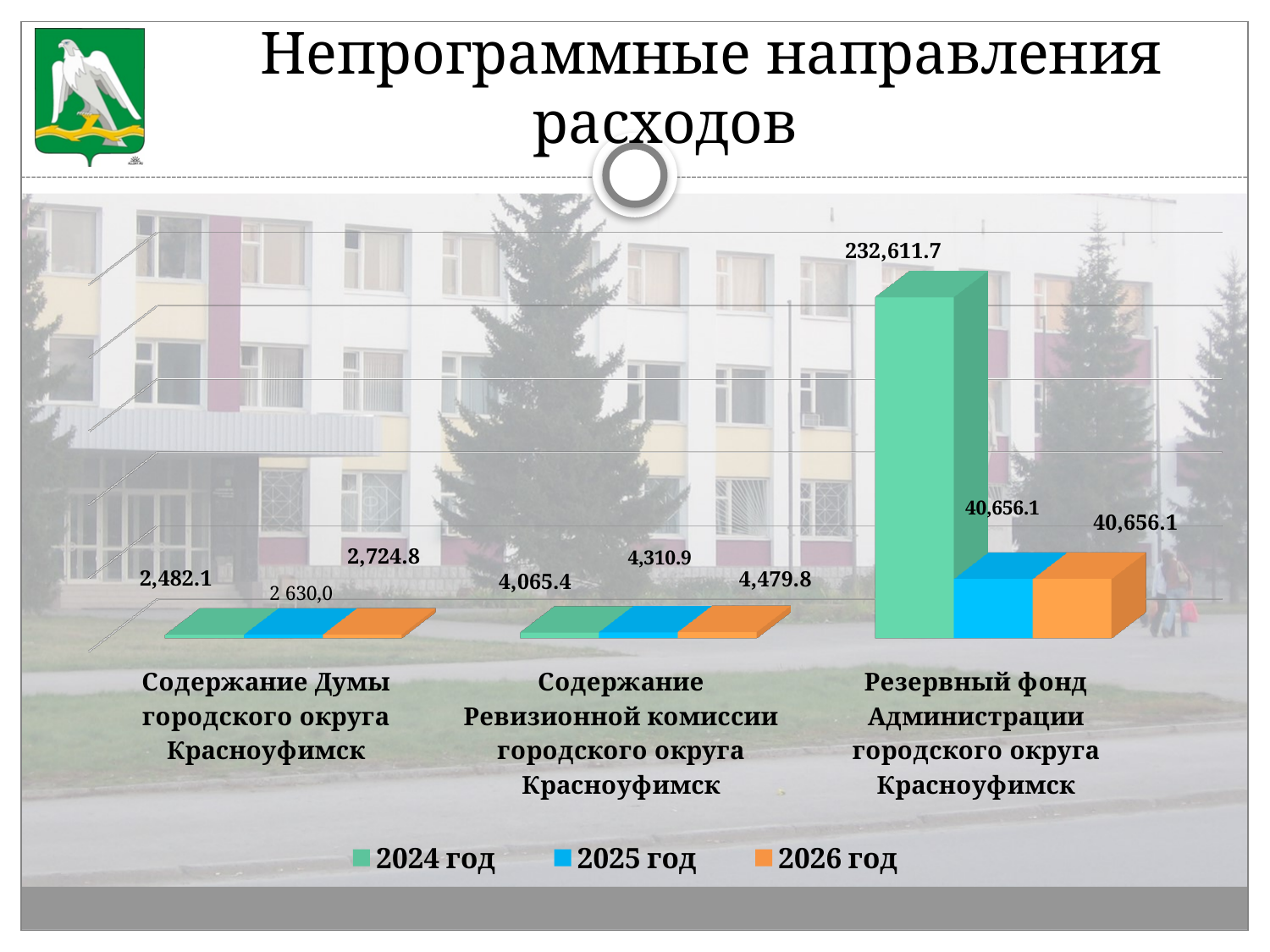
Which is larger for Резервный фонд Администрации городского округа Красноуфимск: the 2024 год value or the 2025 год value? 2024 год What is the difference between the 2026 год and 2024 год values for Содержание Ревизионной комиссии городского округа Красноуфимск? 414.4 Which category has the highest value for 2024 год? Резервный фонд Администрации городского округа Красноуфимск How many series does the legend list? 3 What kind of chart is shown on the slide? Bar chart What is the value for 2024 год for Содержание Думы городского округа Красноуфимск? 2,482.1 Which category has the lowest value for 2025 год? Содержание Думы городского округа Красноуфимск What is the value for 2024 год for Резервный фонд Администрации городского округа Красноуфимск? 232,611.7 How many categories are shown on the x axis of the chart? 3 What is the value for 2026 год for Содержание Думы городского округа Красноуфимск? 2,724.8 What is the value for 2026 год for Резервный фонд Администрации городского округа Красноуфимск? 40,656.1 What is the value for 2025 год for Содержание Ревизионной комиссии городского округа Красноуфимск? 4,310.9